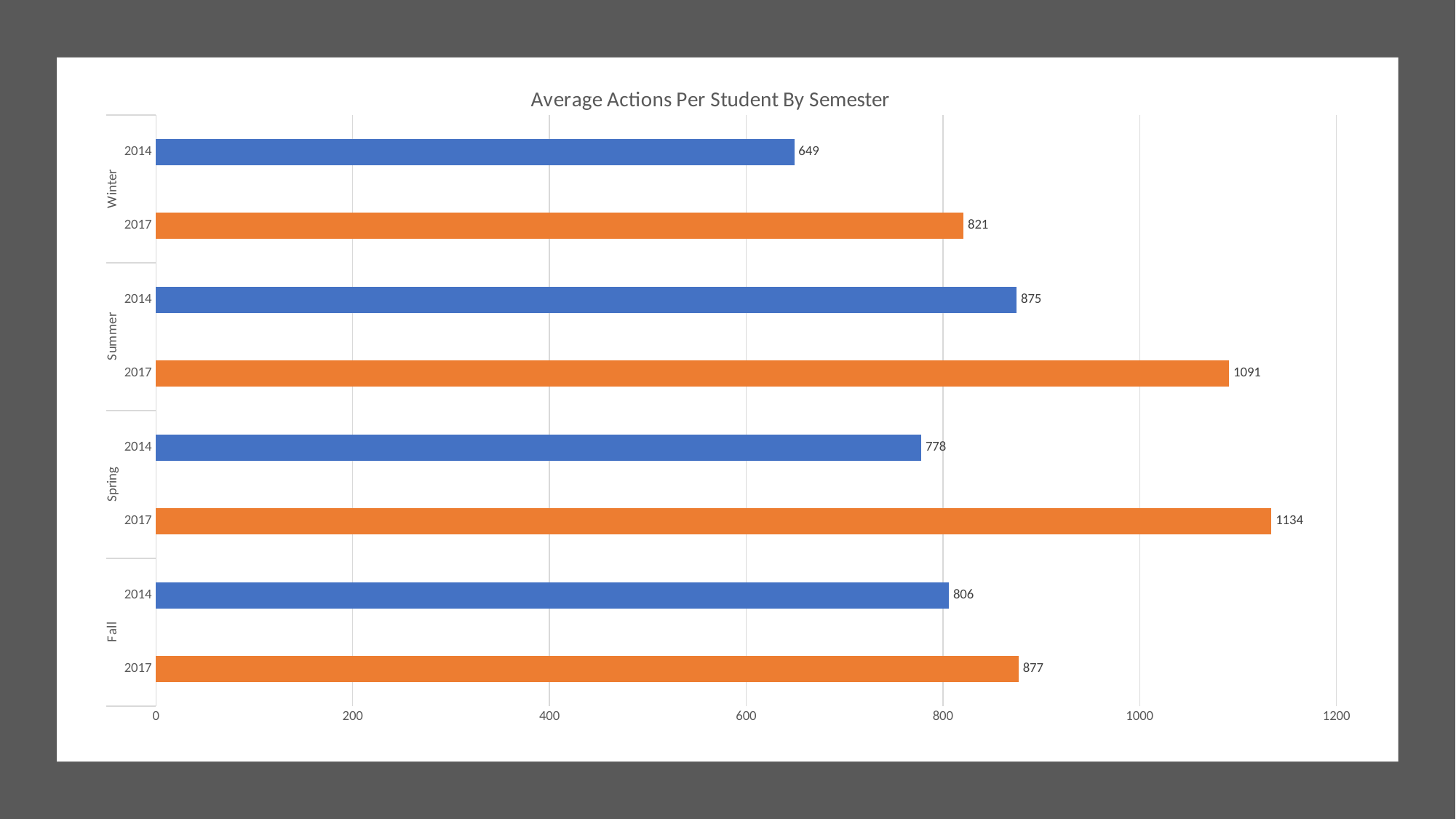
What is the difference between the Spring 2017 and Spring 2014 values? 356 What kind of chart is shown on the slide? Bar chart How many bars are plotted on the chart? 8 What is the difference between the Winter 2017 and Winter 2014 values? 172 Is the value for Summer 2017 greater or less than 1000? greater Which semester and year has the lowest average actions per student? Winter 2014 What is the average actions per student for Fall 2017? 877 What is the average actions per student for Summer 2017? 1091 What is the title of the chart? Average Actions Per Student By Semester What is the average actions per student for Winter 2014? 649 Which semester and year has the highest average actions per student? Spring 2017 Which is larger, the Fall 2014 value or the Summer 2014 value? Summer 2014